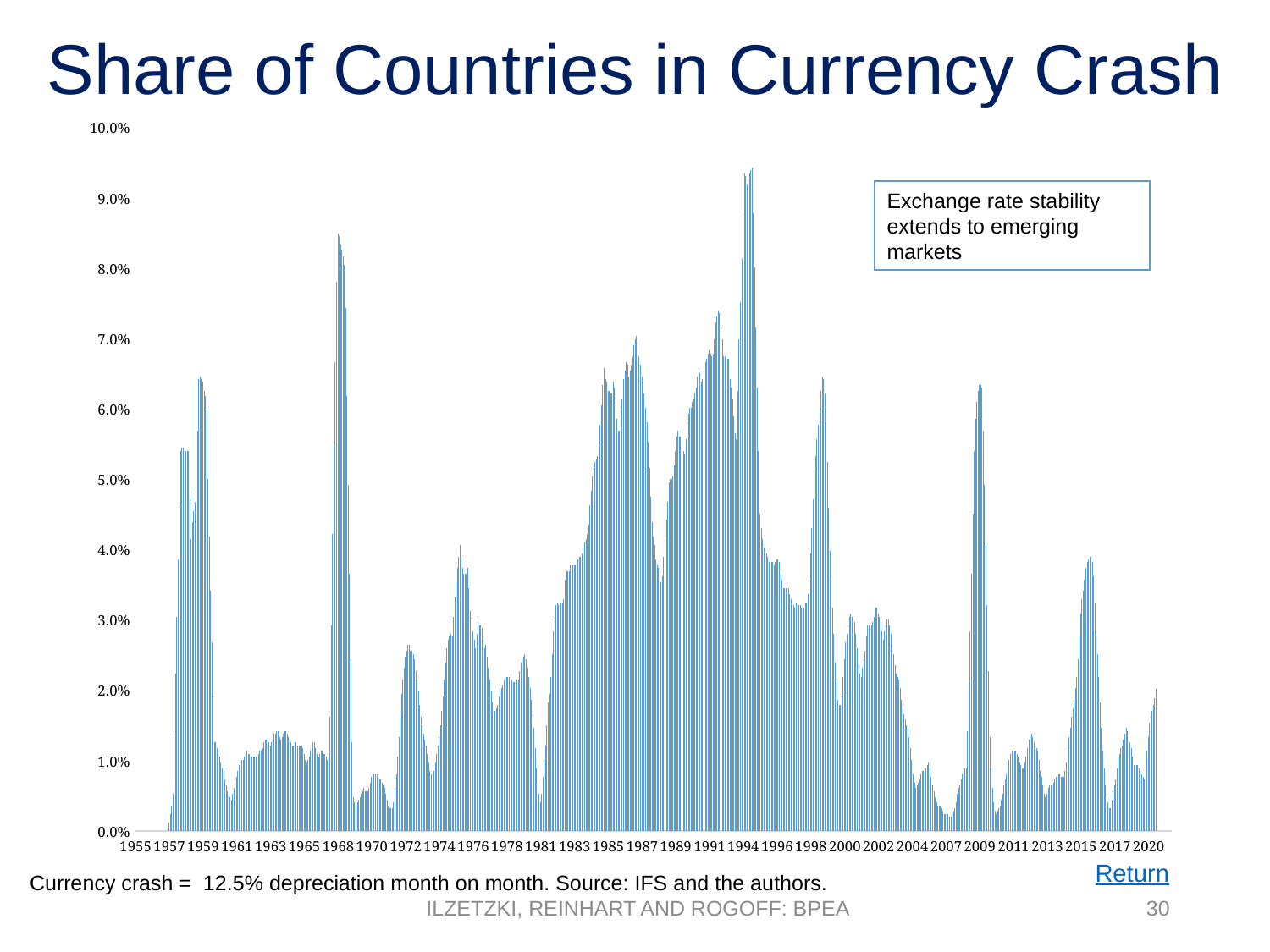
Around which year does the chart reach its highest peak? 1994 What type of chart is shown on the slide? Bar chart What is the title of the chart? Share of Countries in Currency Crash Which peak is higher, the one around 1968 or the one around 1959? 1968 Do the values rise or fall from the 1994 peak to 1996? fall Is the peak value around 2009 greater or less than 6.0%? greater Is the peak value around 1994 greater or less than 9.0%? greater What is the highest value shown on the vertical axis? 10.0% Is the peak value around 1968 greater or less than 8.0%? greater Which peak is higher, the one around 1994 or the one around 2009? 1994